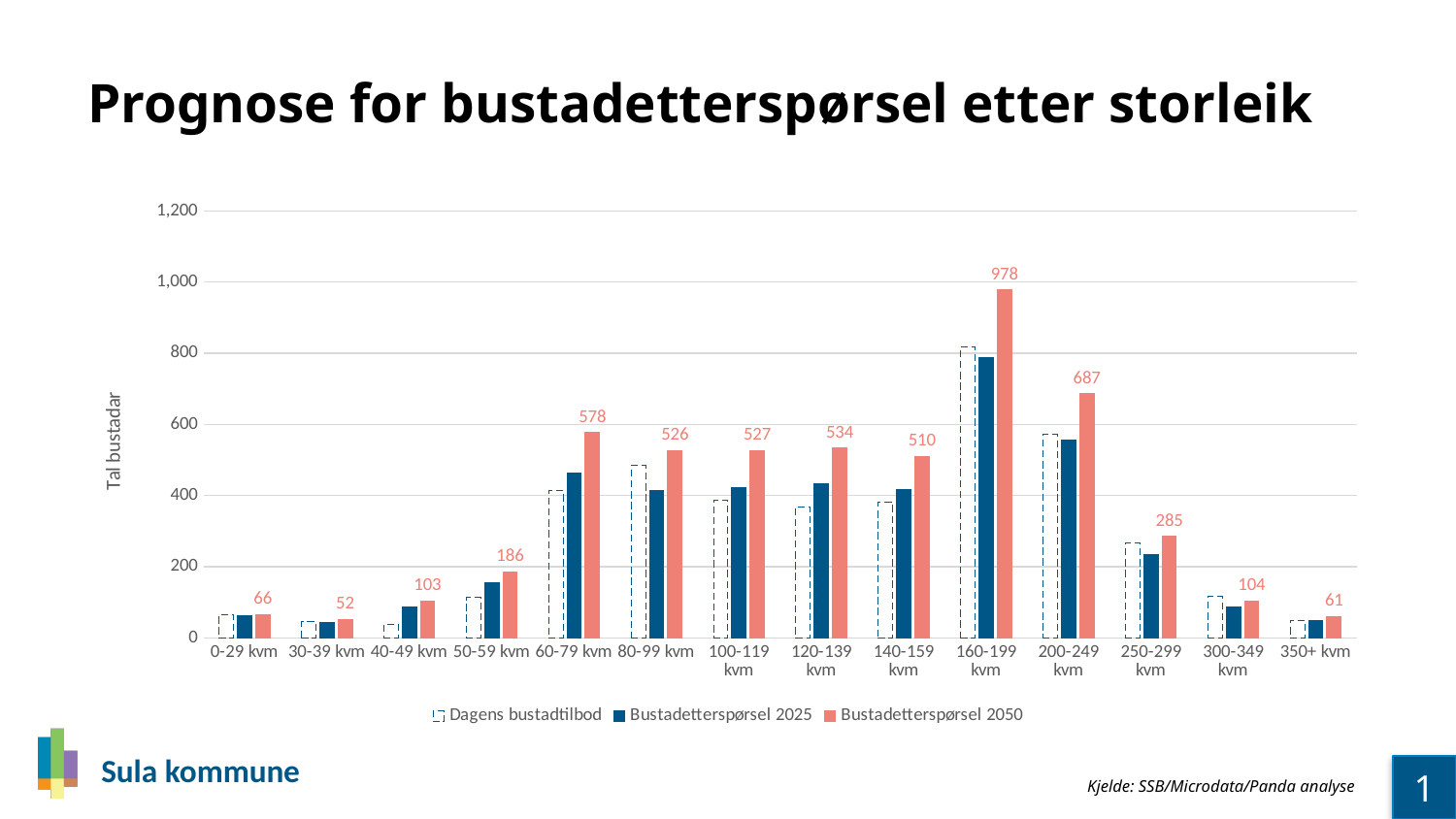
Which category has the highest value for Bustadetterspørsel 2050? 160-199 kvm Which category has the lowest value for Bustadetterspørsel 2050? 30-39 kvm How many series does the legend list? 3 Which is larger for Bustadetterspørsel 2050: 250-299 kvm or 50-59 kvm? 250-299 kvm What kind of chart is shown on the slide? Bar chart How many size categories are shown on the x axis? 14 What is the value for Bustadetterspørsel 2050 in the 160-199 kvm category? 978 What is the difference between the Bustadetterspørsel 2050 values for 160-199 kvm and 200-249 kvm? 291 What is the value for Bustadetterspørsel 2050 in the 60-79 kvm category? 578 Is the value for Dagens bustadtilbod in the 100-119 kvm category greater or less than 600? less Is the value for Bustadetterspørsel 2025 in the 160-199 kvm category greater or less than 600? greater What is the value for Bustadetterspørsel 2050 in the 30-39 kvm category? 52